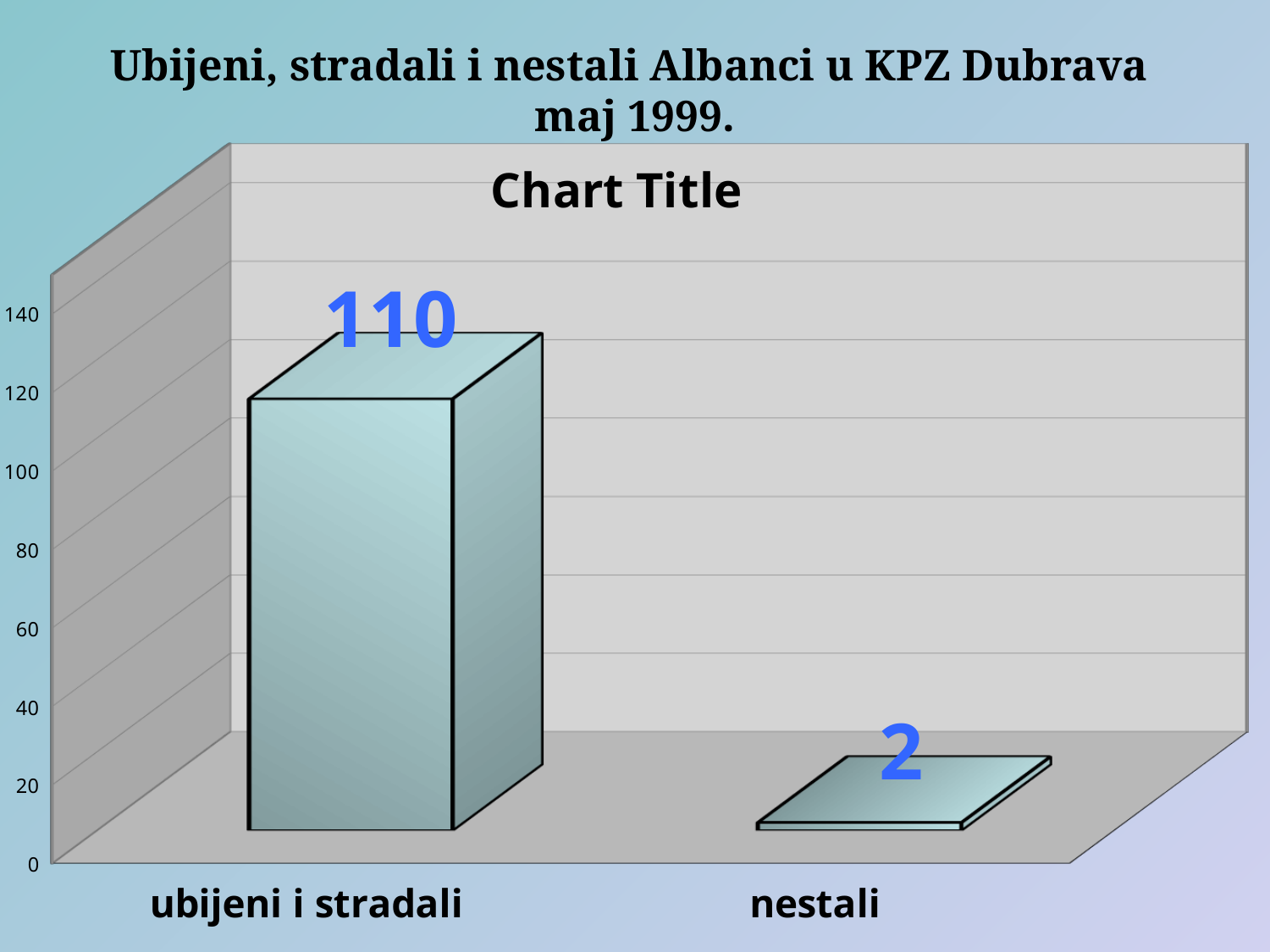
What is the value for "ubijeni i stradali"? 110 Which category has the highest value? ubijeni i stradali What is the highest value labelled on the vertical axis? 140 What is the title printed inside the chart area? Chart Title What is the difference between the values for "ubijeni i stradali" and "nestali"? 108 Is the value for "nestali" greater or less than 20? less Which category has the lowest value? nestali Which is larger, the value for "ubijeni i stradali" or the value for "nestali"? ubijeni i stradali What is the value for "nestali"? 2 What kind of chart is shown on the slide? bar chart How many categories are shown on the x axis? 2 Is the value for "ubijeni i stradali" greater or less than 100? greater